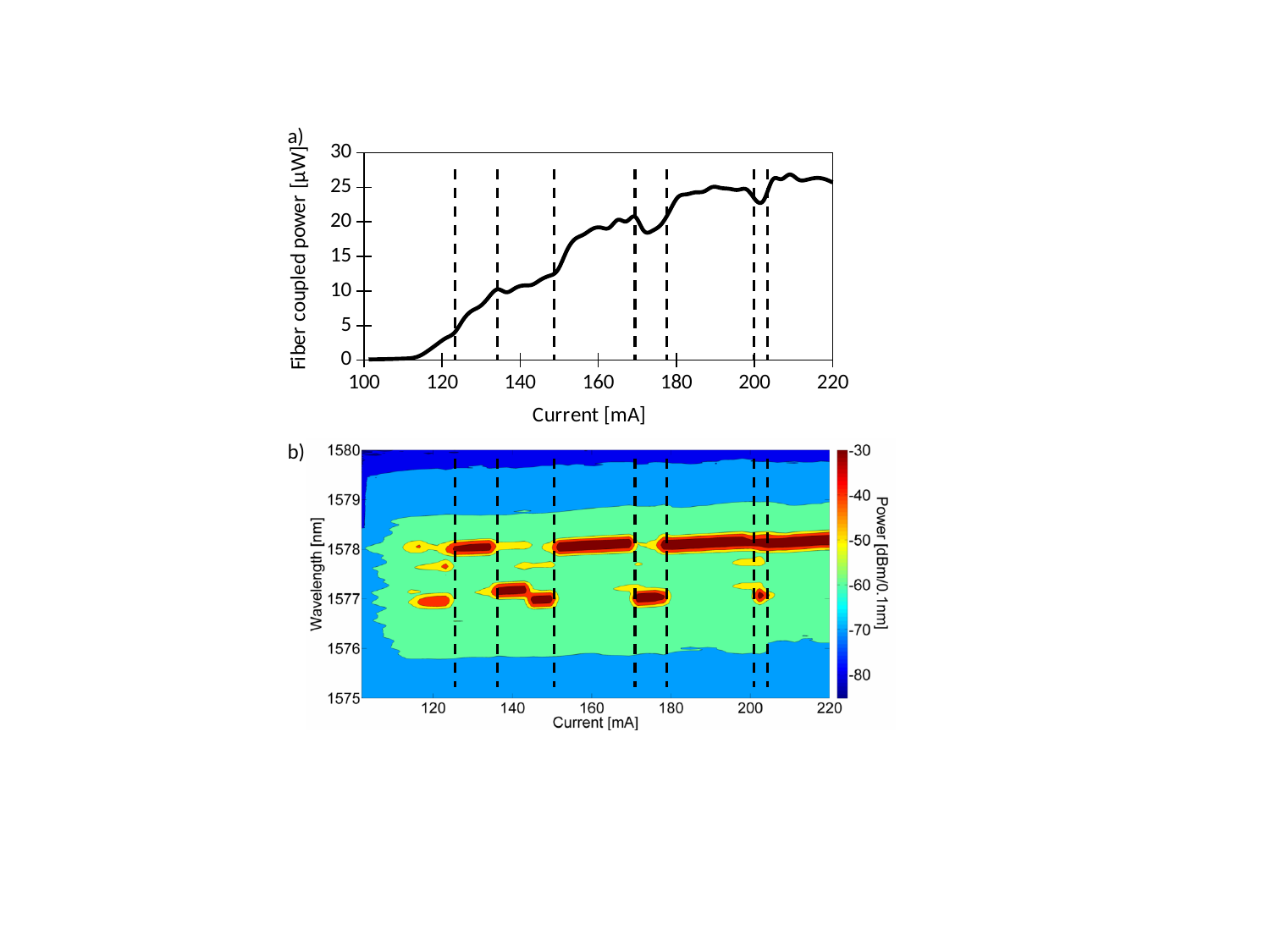
In chart a), does the fiber coupled power generally rise or fall as the current increases from 100 mA to 220 mA? rise In chart a), is the fiber coupled power at 200 mA greater or less than 20 µW? greater What kind of chart is chart b), the bottom chart on the slide? contour (heat) map In chart a), is the fiber coupled power at 140 mA greater or less than 5 µW? greater What is the y-axis label of chart a)? Fiber coupled power [µW] What quantity does the colour bar in chart b) represent? Power [dBm/0.1nm] What kind of chart is chart a), the top chart on the slide? line chart In chart a), is the fiber coupled power at 120 mA greater or less than 5 µW? less How many vertical dashed lines are drawn on chart a)? 7 What is the maximum value shown on the y-axis of chart a)? 30 In chart a), is the fiber coupled power at 140 mA greater or less than at 200 mA? less